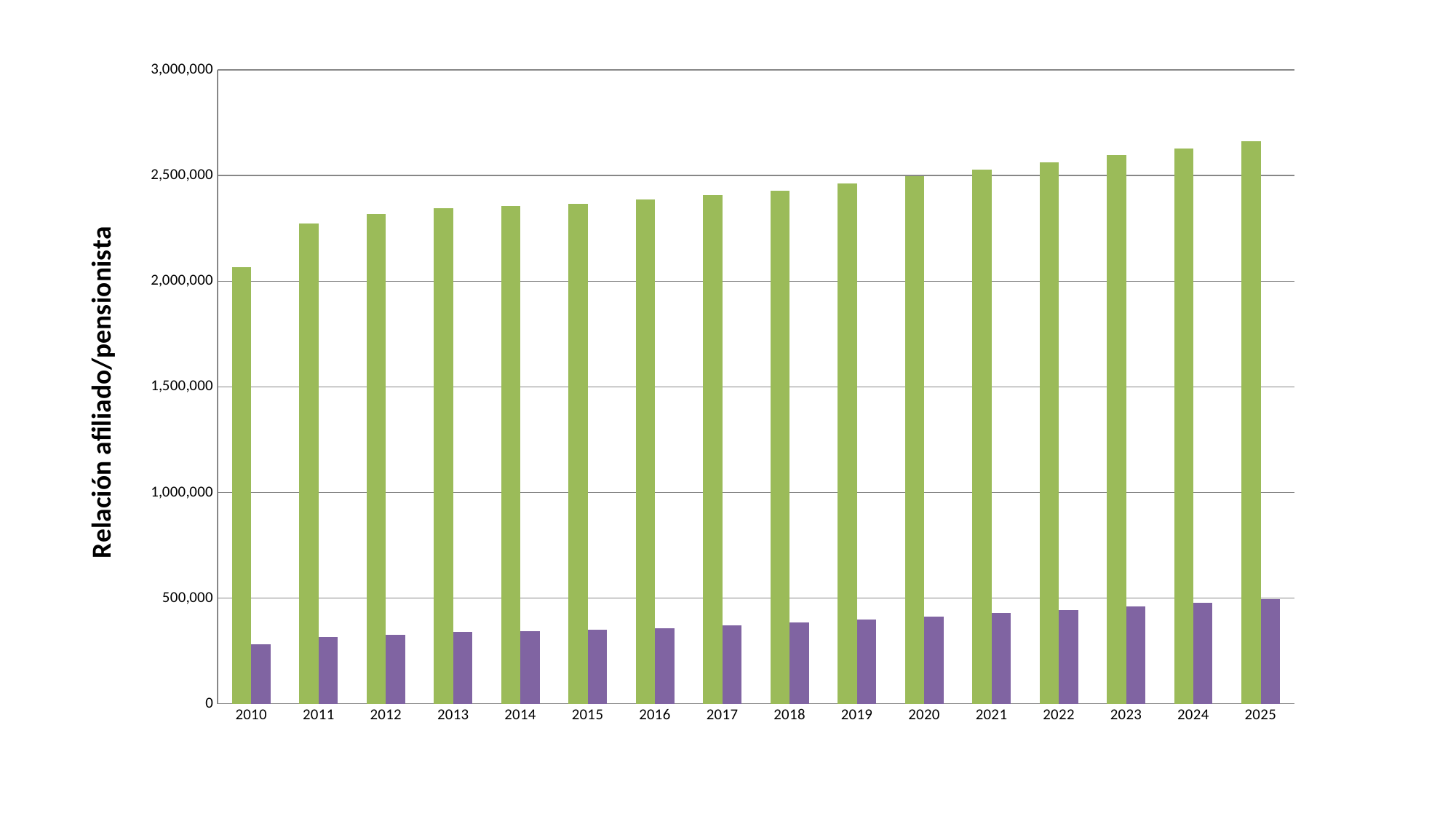
Is the green bar for 2010 greater or less than 2,000,000? greater In which year is the green bar the lowest? 2010 In which year is the green bar the highest? 2025 What kind of chart is shown on the slide? bar chart Do the purple bars rise or fall from 2010 to 2025? rise Do the green bars rise or fall from 2010 to 2025? rise Is the green bar for 2025 greater or less than 2,500,000? greater What is the first year shown on the x axis? 2010 Is the purple bar for 2010 greater or less than 500,000? less What is the label of the vertical axis? Relación afiliado/pensionista In which year is the purple bar the lowest? 2010 How many years are shown on the x axis of the chart? 16